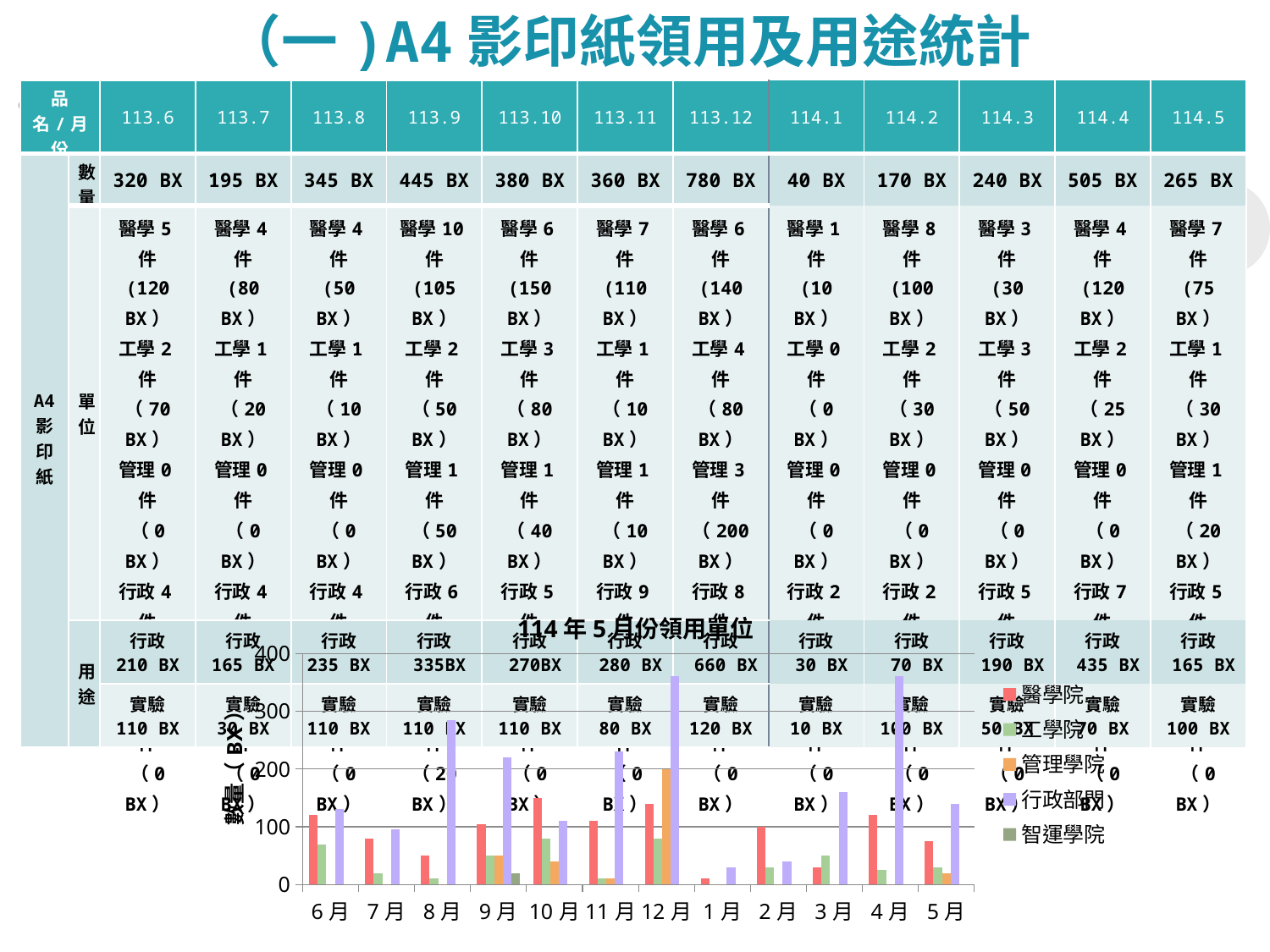
Is the value for 行政部門 in 8月 greater or less than 200? greater Is the value for 醫學院 in 1月 greater or less than 100? less What kind of chart is shown on the slide? bar chart How many series does the chart legend list? 5 How many months are shown along the x axis of the chart? 12 Is the value for 行政部門 in 4月 greater or less than 300? greater In which month is the 管理學院 bar the highest? 12月 In 10月, which is larger: the value for 醫學院 or the value for 行政部門? 醫學院 What is the title of the chart? 114年5月份領用單位 What is the label of the chart's vertical axis? 數量 (BX)